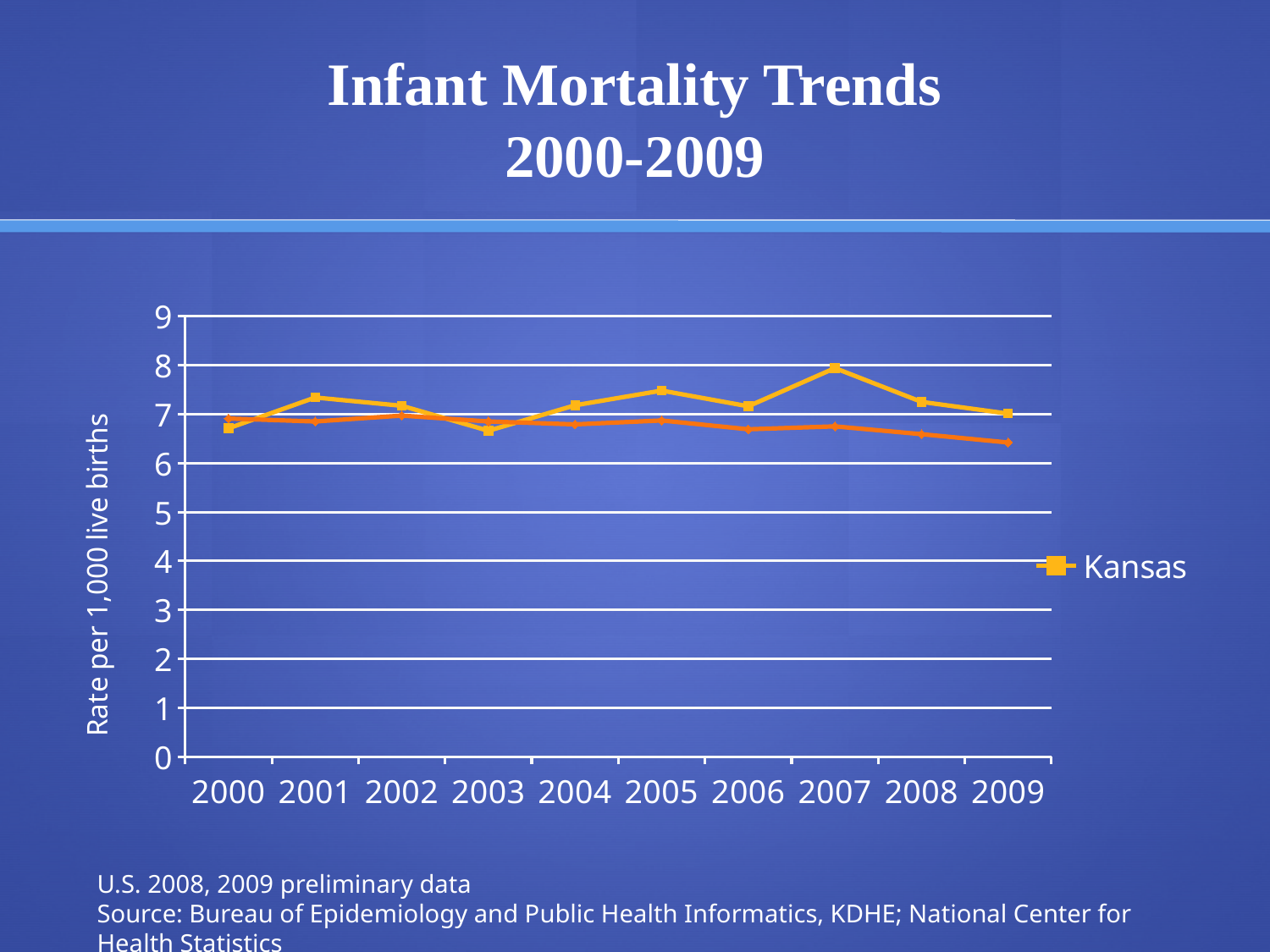
Is the Kansas value for 2007 greater or less than 7? greater Which is larger for Kansas, the value for 2007 or the value for 2006? 2007 How many years are shown on the x axis of the chart? 10 Is the Kansas value for 2005 greater or less than 7? greater How many series does the chart's legend list? 1 What is the label on the chart's y axis? Rate per 1,000 live births Is the Kansas value for 2003 greater or less than 7? less What kind of chart is shown on the slide? line chart Which series is named in the chart's legend? Kansas In which year is the Kansas infant mortality rate highest? 2007 Does the Kansas line rise or fall from 2007 to 2009? fall